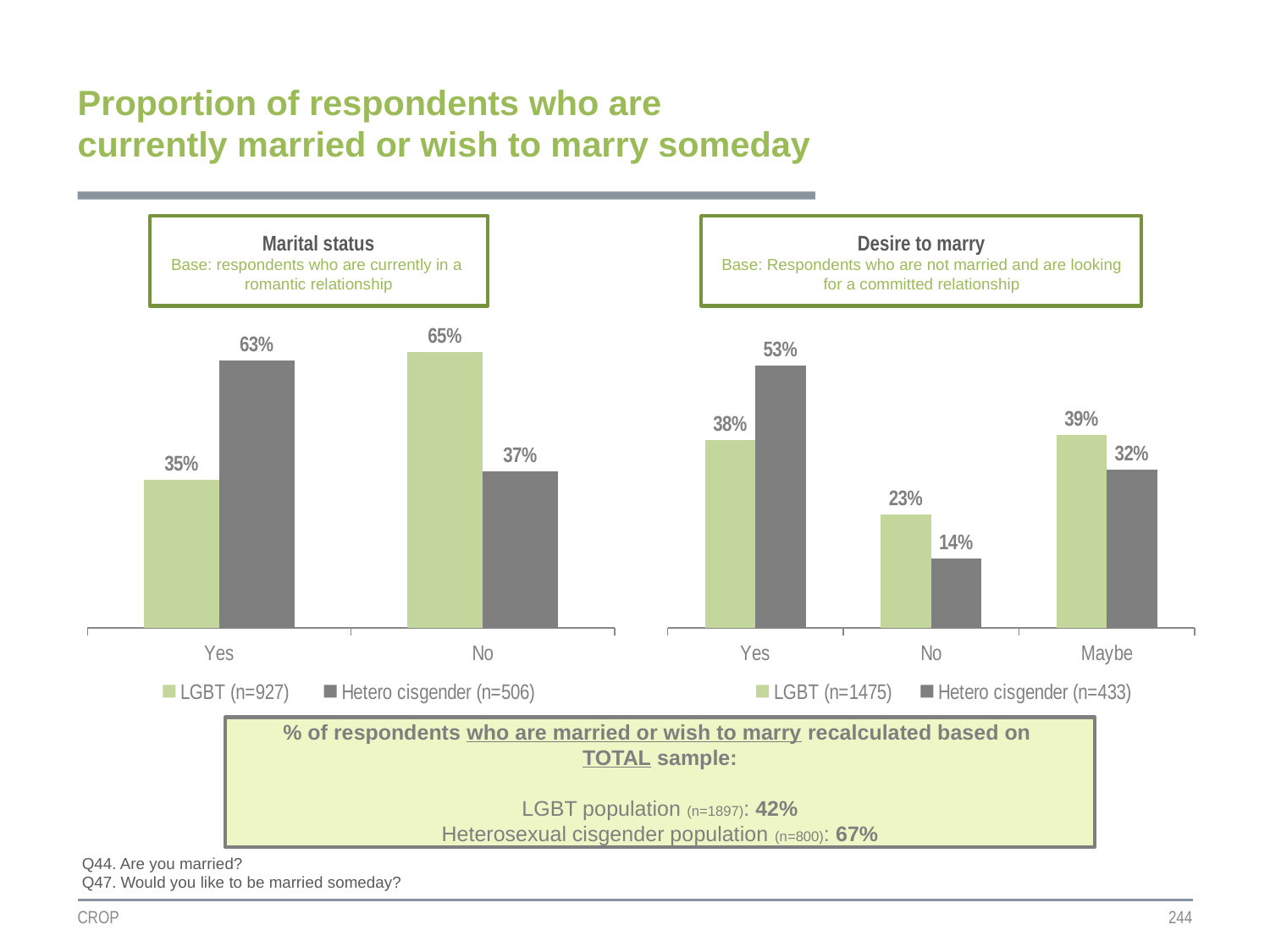
What type of chart is the Marital status chart? Bar chart In the Desire to marry chart, what percentage of LGBT respondents answered Maybe? 39% In the Marital status chart, what is the difference between the Hetero cisgender and LGBT values for Yes? 28% How many series does the legend of the Marital status chart list? 2 In the Marital status chart, what percentage of Hetero cisgender respondents answered No? 37% In the Desire to marry chart, what is the difference between the LGBT and Hetero cisgender values for No? 9% In the Desire to marry chart, which group has the larger value for Maybe, LGBT or Hetero cisgender? LGBT In the Marital status chart, what percentage of LGBT respondents answered Yes? 35% In the Desire to marry chart, what percentage of Hetero cisgender respondents answered Yes? 53% In the Desire to marry chart, which category has the lowest value for Hetero cisgender respondents? No How many categories are shown on the x axis of the Desire to marry chart? 3 In the Desire to marry chart, which category has the highest value for LGBT respondents? Maybe